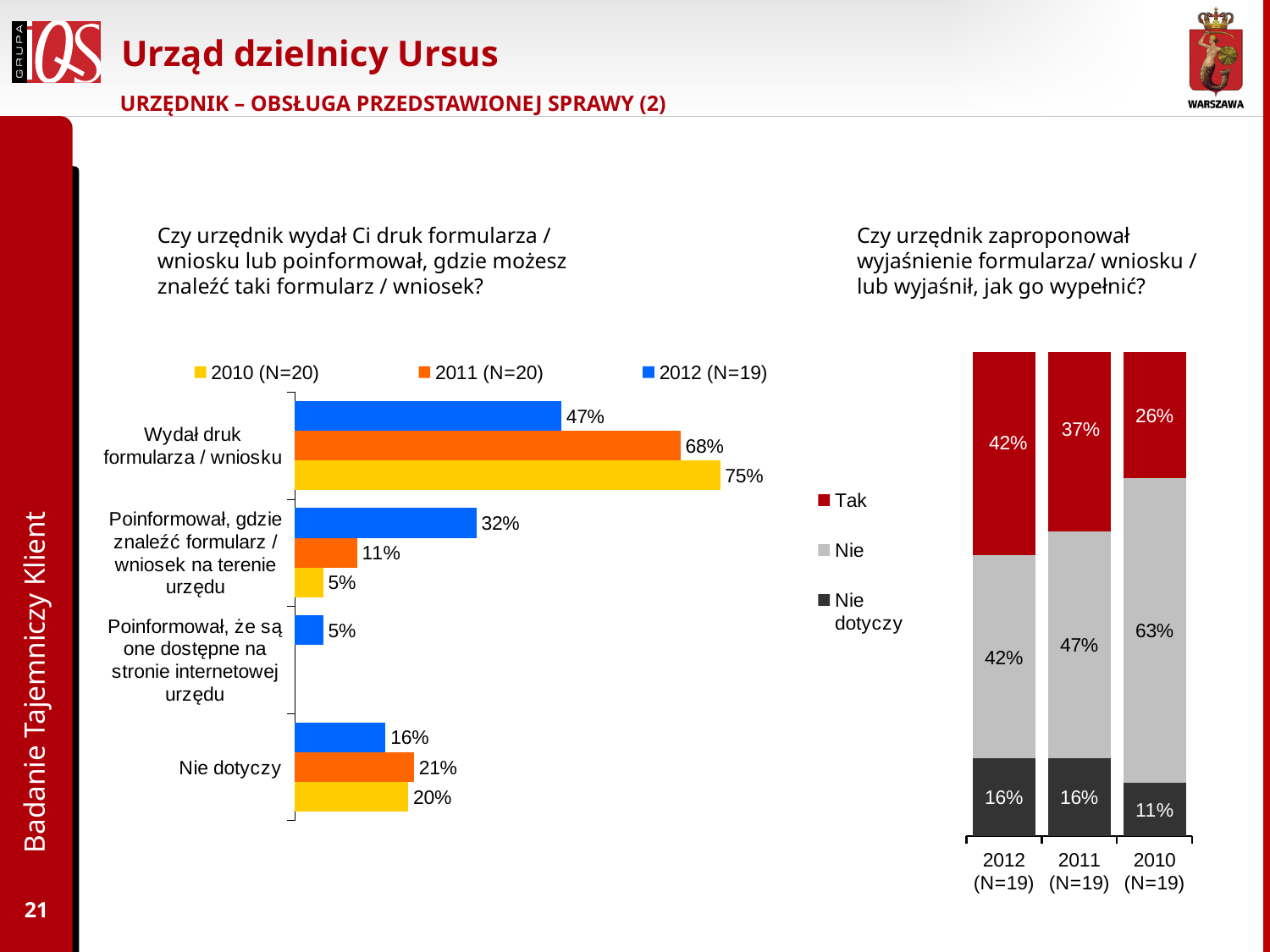
In the left chart, what is the 2012 (N=19) value for 'Poinformował, gdzie znaleźć formularz / wniosek na terenie urzędu'? 32% What type of chart is the left chart? Bar chart In the left chart, what is the 2011 (N=20) value for 'Nie dotyczy'? 21% In the right chart, which year has the lowest 'Tak' value? 2010 (N=19) In the right chart, what is the 'Tak' value for 2012 (N=19)? 42% In the right chart, what is the total of the stacked bar for 2011 (N=19)? 100% In the left chart, what is the difference between the 2011 (N=20) and 2012 (N=19) values for 'Wydał druk formularza / wniosku'? 21% In the left chart, how many series does the legend list? 3 In the left chart, which series has the highest value for 'Wydał druk formularza / wniosku'? 2010 (N=20) In the right chart, how many categories are shown on the x axis? 3 In the left chart, what is the 2010 (N=20) value for 'Wydał druk formularza / wniosku'? 75% In the right chart, what is the 'Nie' value for 2010 (N=19)? 63%